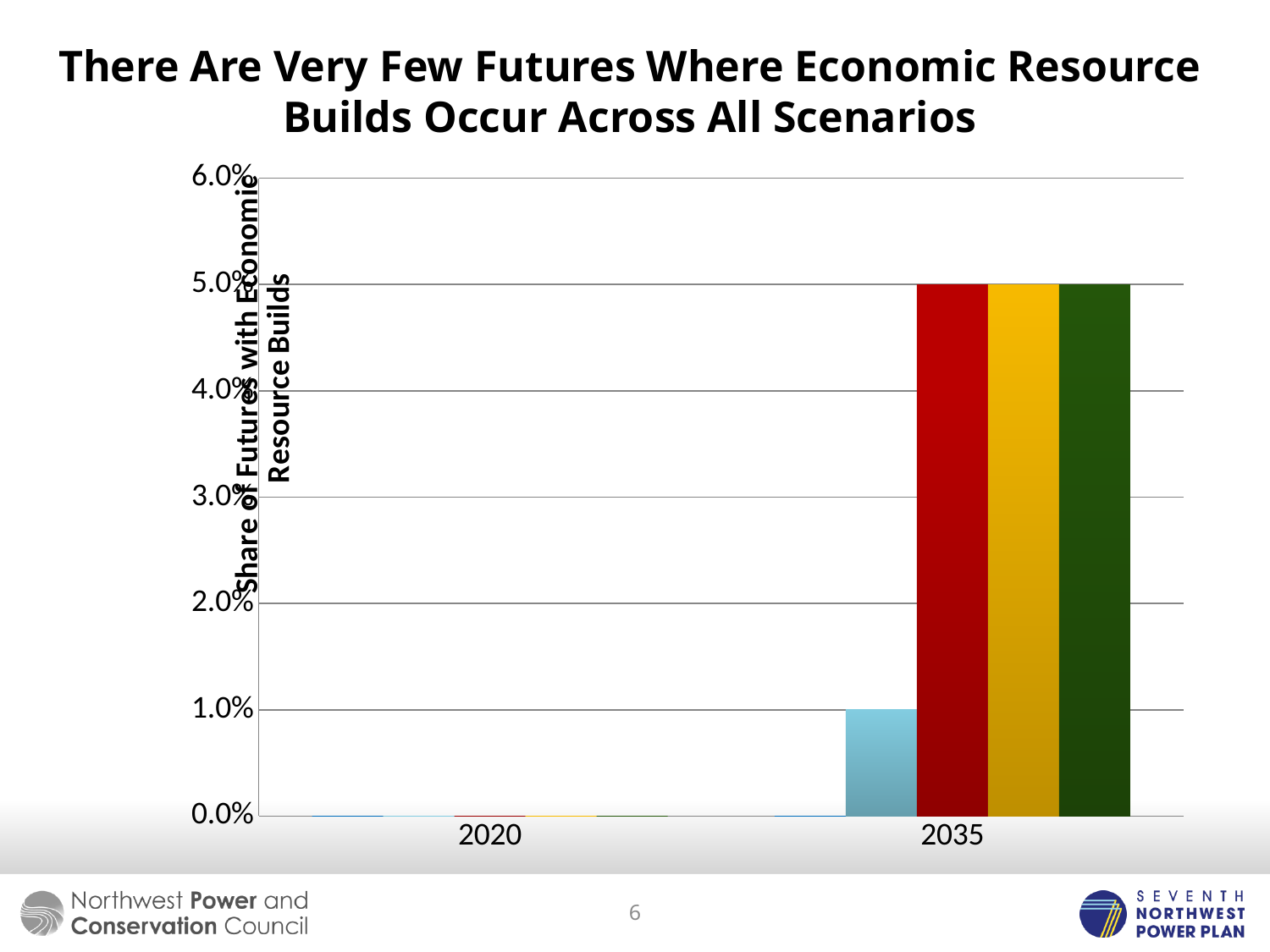
What are the two categories on the x axis? 2020 and 2035 What value does the red bar reach for 2035? 5.0% What is the label of the y axis? Share of Futures with Economic Resource Builds What is the difference between the red bar and the light blue bar for 2035? 4.0% Which category, 2020 or 2035, has the higher bars? 2035 What value does the light blue bar reach for 2035? 1.0% Is the value of the yellow bar for 2035 greater or less than 3.0%? greater How many categories are shown on the x axis? 2 What kind of chart is shown on the slide? bar chart Do the values rise or fall from 2020 to 2035? rise What value does the green bar reach for 2035? 5.0% Is the value of the light blue bar for 2035 greater or less than 2.0%? less